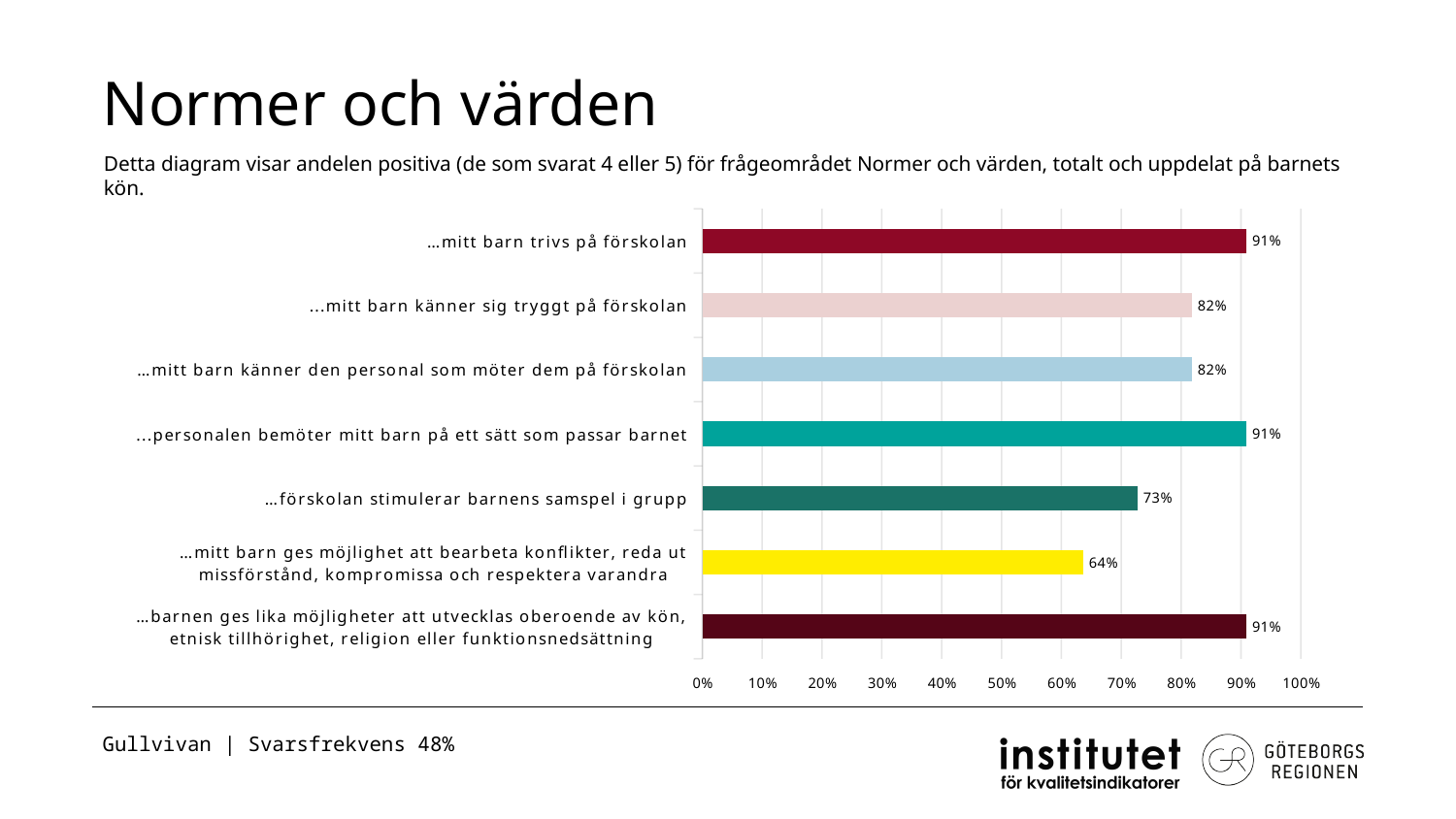
What kind of chart is shown on the slide? bar chart Is the value for "…förskolan stimulerar barnens samspel i grupp" greater or less than 80%? less What is the value for "...mitt barn känner sig tryggt på förskolan"? 82% Which category has the lowest value? …mitt barn ges möjlighet att bearbeta konflikter, reda ut missförstånd, kompromissa och respektera varandra What is the title of the slide? Normer och värden How many categories are shown in the chart? 7 What is the value for "…mitt barn trivs på förskolan"? 91% What is the value for "…förskolan stimulerar barnens samspel i grupp"? 73% Which is larger: the value for "...personalen bemöter mitt barn på ett sätt som passar barnet" or the value for "…mitt barn känner den personal som möter dem på förskolan"? ...personalen bemöter mitt barn på ett sätt som passar barnet What is the difference between the value for "...mitt barn känner sig tryggt på förskolan" and the value for "…mitt barn ges möjlighet att bearbeta konflikter, reda ut missförstånd, kompromissa och respektera varandra"? 18% What is the value for "…mitt barn ges möjlighet att bearbeta konflikter, reda ut missförstånd, kompromissa och respektera varandra"? 64% What is the difference between the value for "…mitt barn trivs på förskolan" and the value for "…förskolan stimulerar barnens samspel i grupp"? 18%